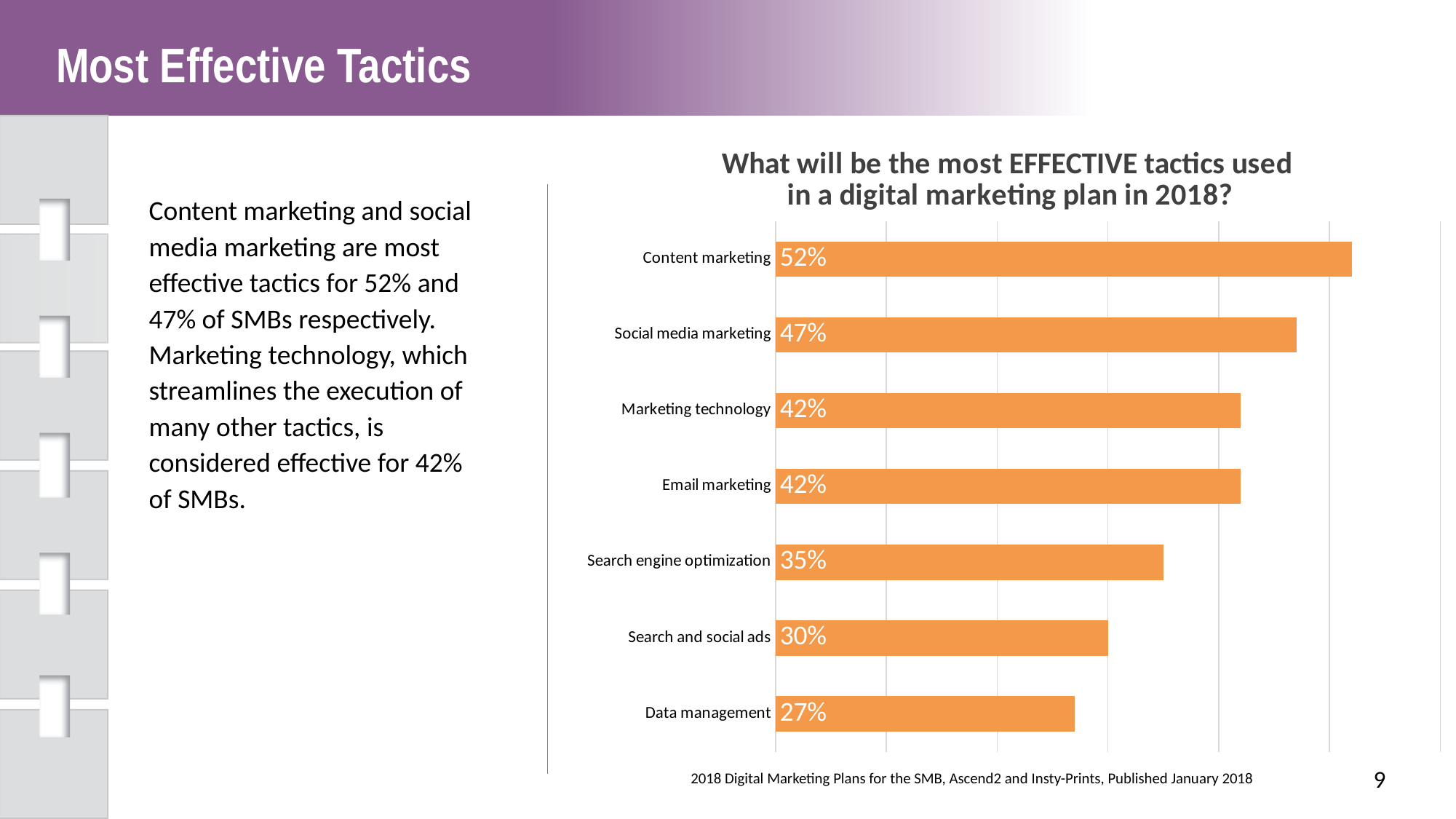
What is the difference between the values for Content marketing and Social media marketing? 5% Which two tactics share the same value of 42%? Marketing technology and Email marketing Which tactic has the highest value in the chart? Content marketing How many tactics are listed in the chart? 7 Which has a larger value, Social media marketing or Search engine optimization? Social media marketing What percentage of SMBs consider content marketing to be among the most effective tactics? 52% What kind of chart is shown on the slide? Bar chart What is the title of the chart? What will be the most EFFECTIVE tactics used in a digital marketing plan in 2018? What is the difference between the values for Search and social ads and Data management? 3% What value is shown for Data management? 27% What value is shown for Search engine optimization? 35% Which tactic has the lowest value in the chart? Data management